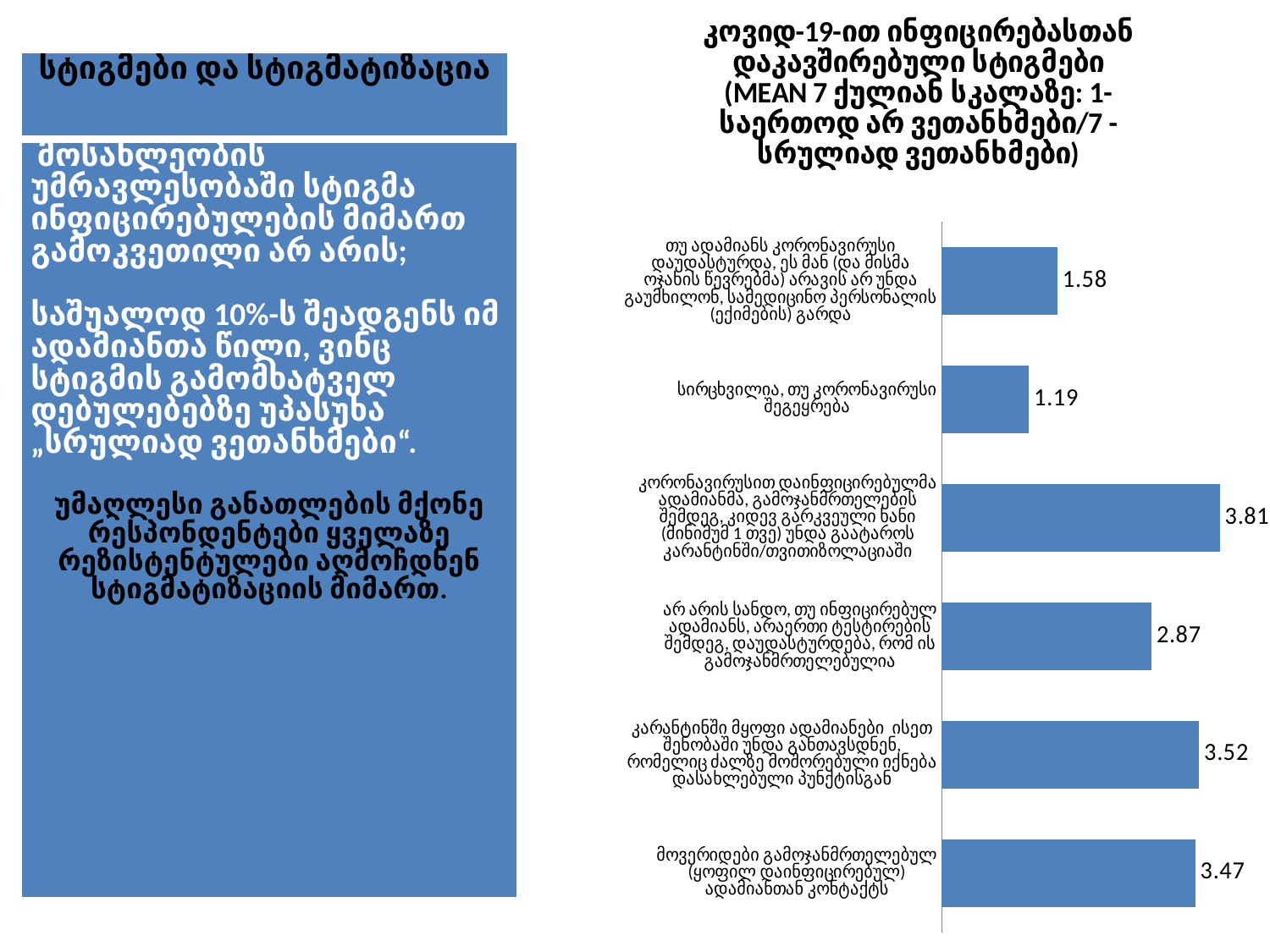
What is the difference between the mean values for the statements beginning "კარანტინში მყოფი ადამიანები..." (3.52) and "მოვერიდები გამოჯანმრთელებულ..." (3.47)? 0.05 According to the chart title, what scale are the mean values measured on? 7-point scale (1 - strongly disagree / 7 - strongly agree) How many statements are shown in the chart? 6 What is the mean value for the statement "მოვერიდები გამოჯანმრთელებულ (ყოფილ დაინფიცირებულ) ადამიანთან კონტაქტს"? 3.47 Which statement has the highest mean value? კორონავირუსით დაინფიცირებულმა ადამიანმა, გამოჯანმრთელების შემდეგ, კიდევ გარკვეული ხანი (მინიმუმ 1 თვე) უნდა გაატაროს კარანტინში/თვითიზოლაციაში Which statement has the lowest mean value? სირცხვილია, თუ კორონავირუსი შეგეყრება What is the mean value for the statement "სირცხვილია, თუ კორონავირუსი შეგეყრება"? 1.19 What is the mean value for the statement beginning "არ არის სანდო, თუ ინფიცირებულ ადამიანს..."? 2.87 How many statements have a mean value above 3? 3 What type of chart is shown on the slide? Bar chart What is the difference between the highest mean value (3.81) and the lowest mean value (1.19)? 2.62 Which has a higher mean value: the statement beginning "თუ ადამიანს კორონავირუსი დაუდასტურდა..." or the statement "სირცხვილია, თუ კორონავირუსი შეგეყრება"? თუ ადამიანს კორონავირუსი დაუდასტურდა...